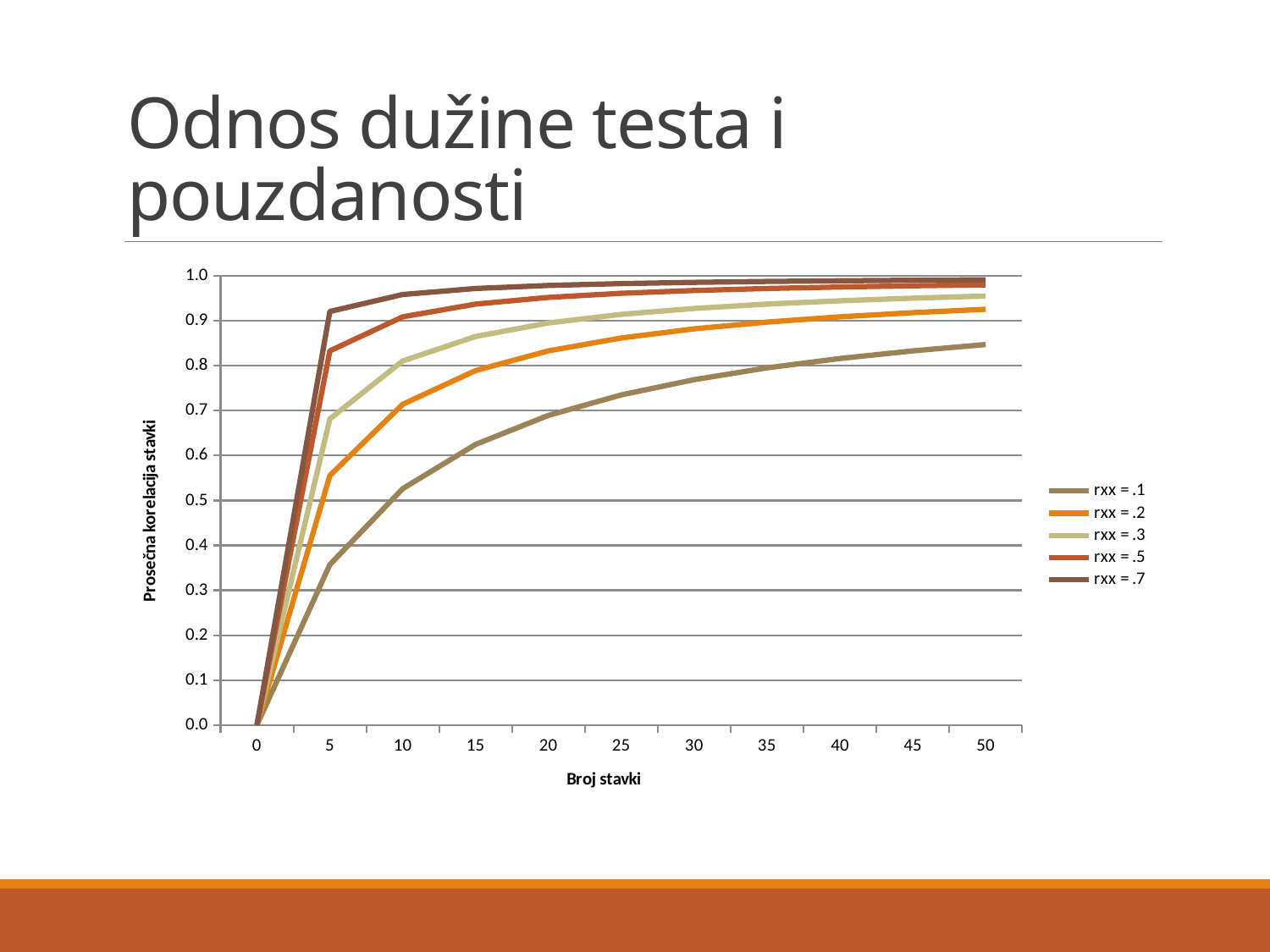
What is the title of the y axis? Prosečna korelacija stavki Do the values for the rxx = .1 series rise or fall as the number of items increases along the x axis? rise Which series has the lowest value at 10 items? rxx = .1 At 5 items, which is larger: the value for rxx = .3 or the value for rxx = .2? rxx = .3 Is the value for rxx = .1 at 5 items greater or less than 0.5? less What is the title of the x axis? Broj stavki How many series does the legend list? 5 What is the value of the rxx = .1 series at 0 items? 0.0 What kind of chart is shown on the slide? line chart Is the value for rxx = .1 at 50 items greater or less than 0.9? less Is the value for rxx = .7 at 5 items greater or less than 0.8? greater